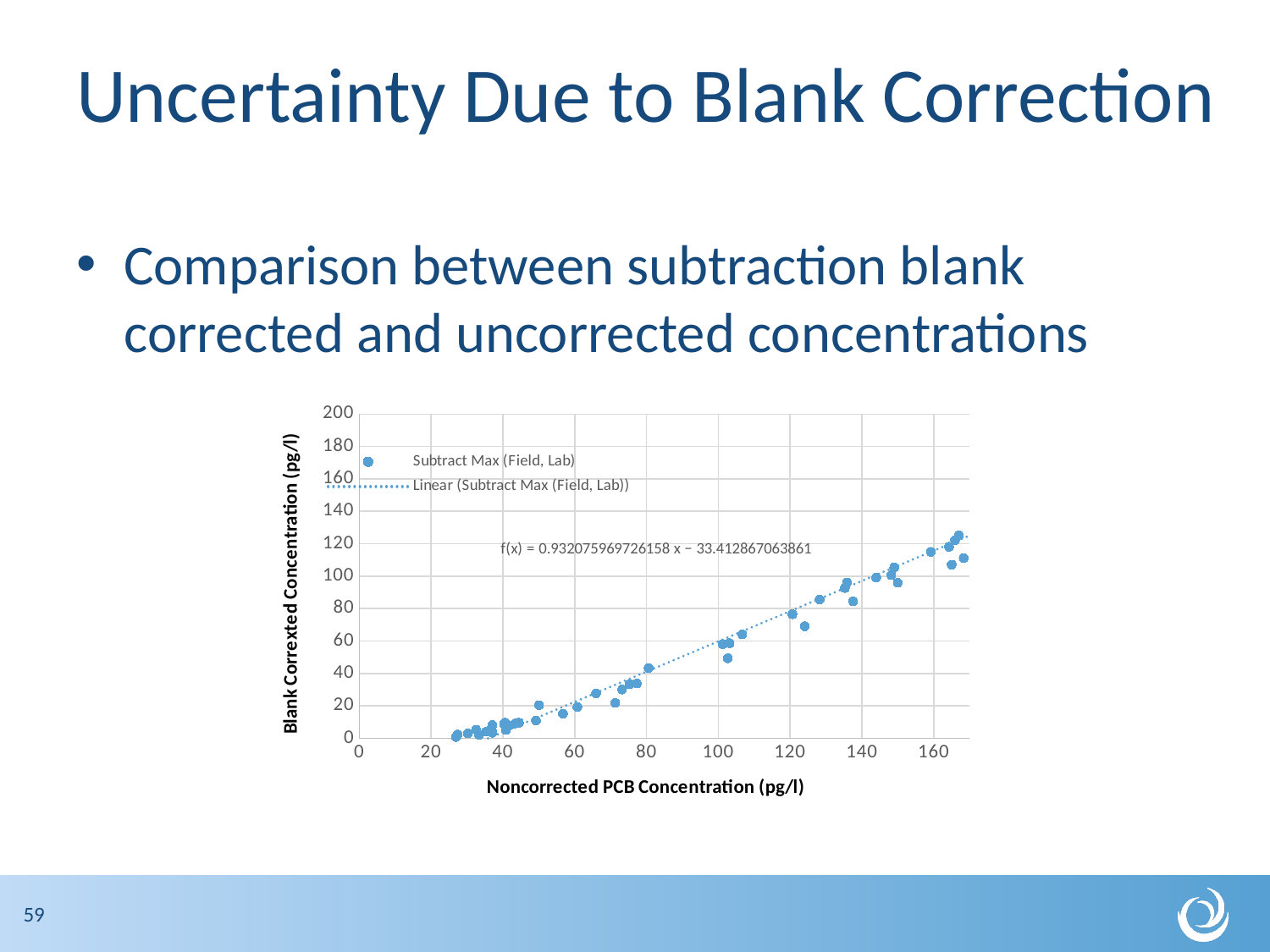
Are the Blank Corrected Concentration values for points with Noncorrected PCB Concentration near 165 pg/l greater or less than 100? greater What kind of chart is shown on the slide? scatter chart What is the title of the x axis of the chart? Noncorrected PCB Concentration (pg/l) Is the Blank Corrected Concentration for the point at about 80 pg/l Noncorrected PCB Concentration greater or less than 60? less Do the plotted values rise or fall as the Noncorrected PCB Concentration increases along the x axis? rise What trendline equation is printed on the chart? f(x) = 0.932075969726158 x − 33.412867063861 What is the highest value shown on the y axis of the chart? 200 How many entries does the chart legend list? 2 Is the Blank Corrected Concentration for the point at about 120 pg/l Noncorrected PCB Concentration greater or less than 60? greater Which has the larger Blank Corrected Concentration: the point at about 100 pg/l Noncorrected or the point at about 140 pg/l Noncorrected? the point at about 140 pg/l